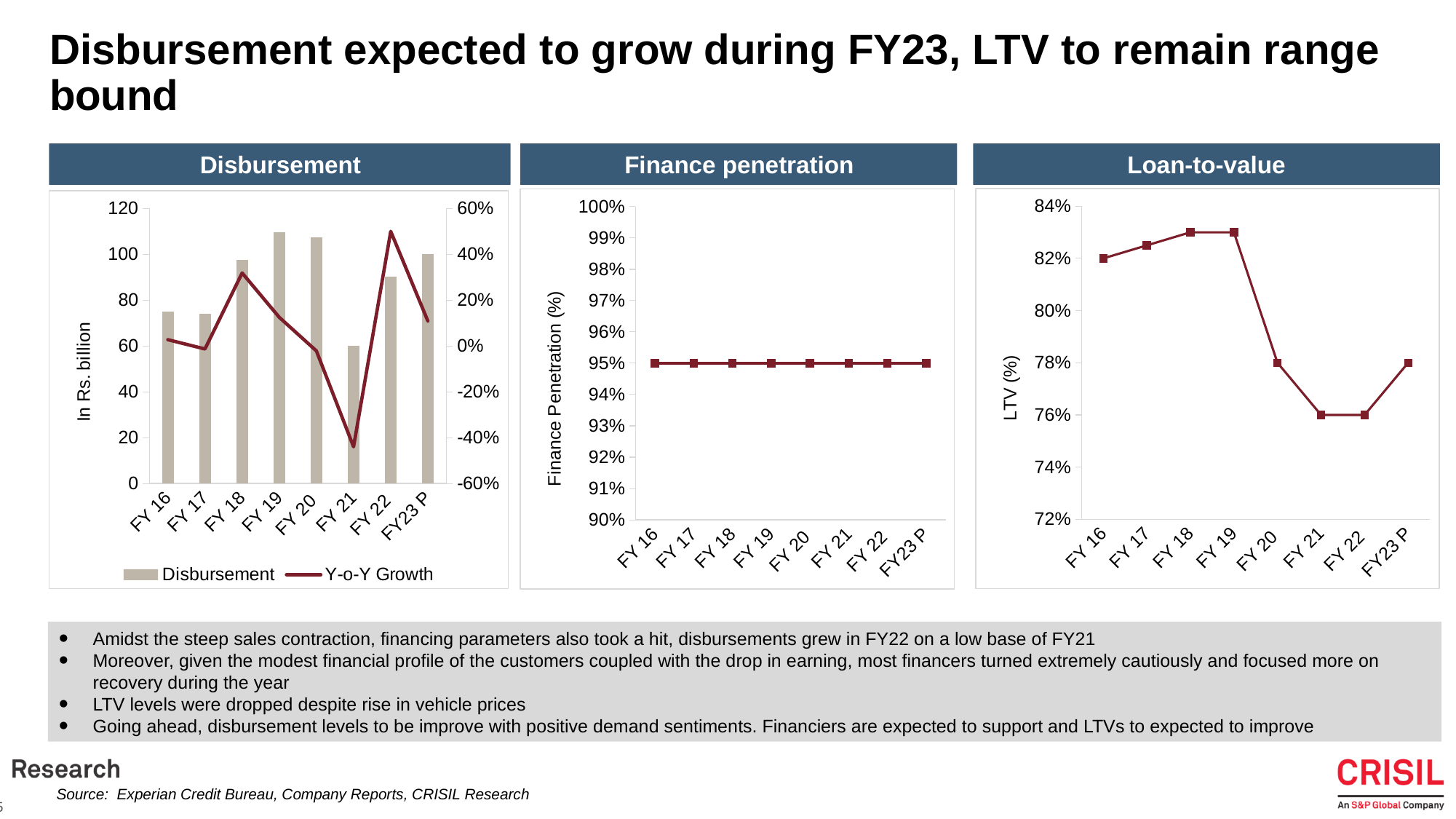
On the Disbursement chart, what kind of chart is it? Combined bar and line chart On the Disbursement chart, is the Y-o-Y Growth for FY 21 greater or less than -20%? less On the Disbursement chart, which fiscal year has the lowest disbursement bar? FY 21 On the Finance penetration chart, do the values rise, fall or stay flat from FY 16 to FY23 P? Stay flat On the Disbursement chart, how many series does the legend list? 2 On the Finance penetration chart, what is the finance penetration for FY 16? 95% On the Finance penetration chart, how many fiscal years are plotted? 8 On the Loan-to-value chart, what is the LTV for FY 21? 76% On the Loan-to-value chart, which is larger, the LTV for FY 16 or for FY 22? FY 16 On the Disbursement chart, is the disbursement value for FY 21 greater or less than 80? less On the Disbursement chart, is the disbursement value for FY 19 greater or less than 100? greater On the Loan-to-value chart, what is the LTV for FY23 P? 78%